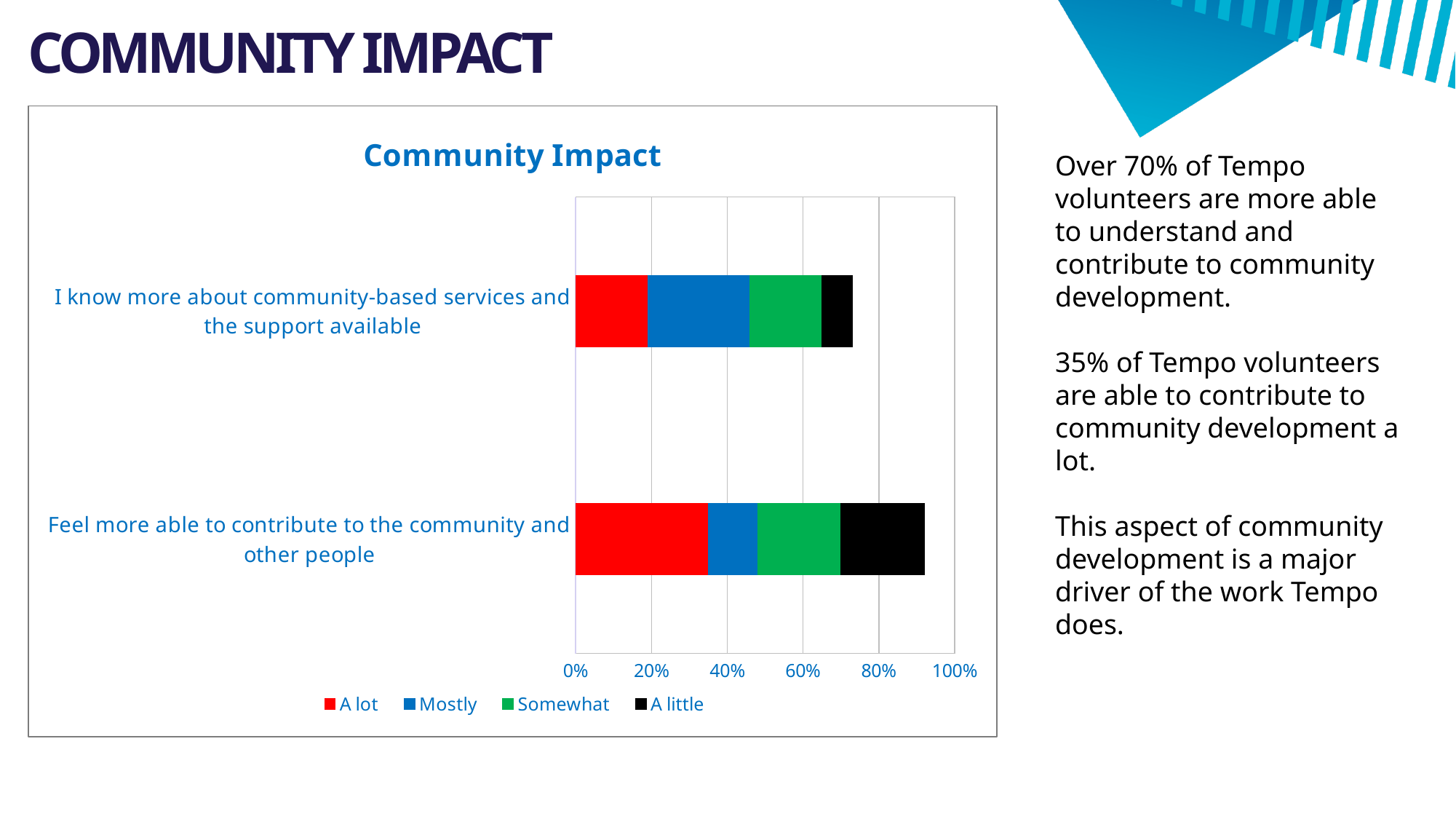
Which colour represents the 'A lot' series in the chart? Red Is the 'A lot' segment for 'Feel more able to contribute to the community and other people' greater or less than 20%? greater How many series does the chart's legend list? 4 What is the title of the chart? Community Impact Which category has the larger 'A little' segment? Feel more able to contribute to the community and other people How many categories are plotted in the chart? 2 What kind of chart is shown on the slide? Stacked bar chart Which category has the larger 'A lot' segment? Feel more able to contribute to the community and other people Which category has the larger 'Mostly' segment? I know more about community-based services and the support available Which category has the longest total bar? Feel more able to contribute to the community and other people Is the total length of the bar for 'Feel more able to contribute to the community and other people' greater or less than 80%? greater Is the total length of the bar for 'I know more about community-based services and the support available' greater or less than 80%? less